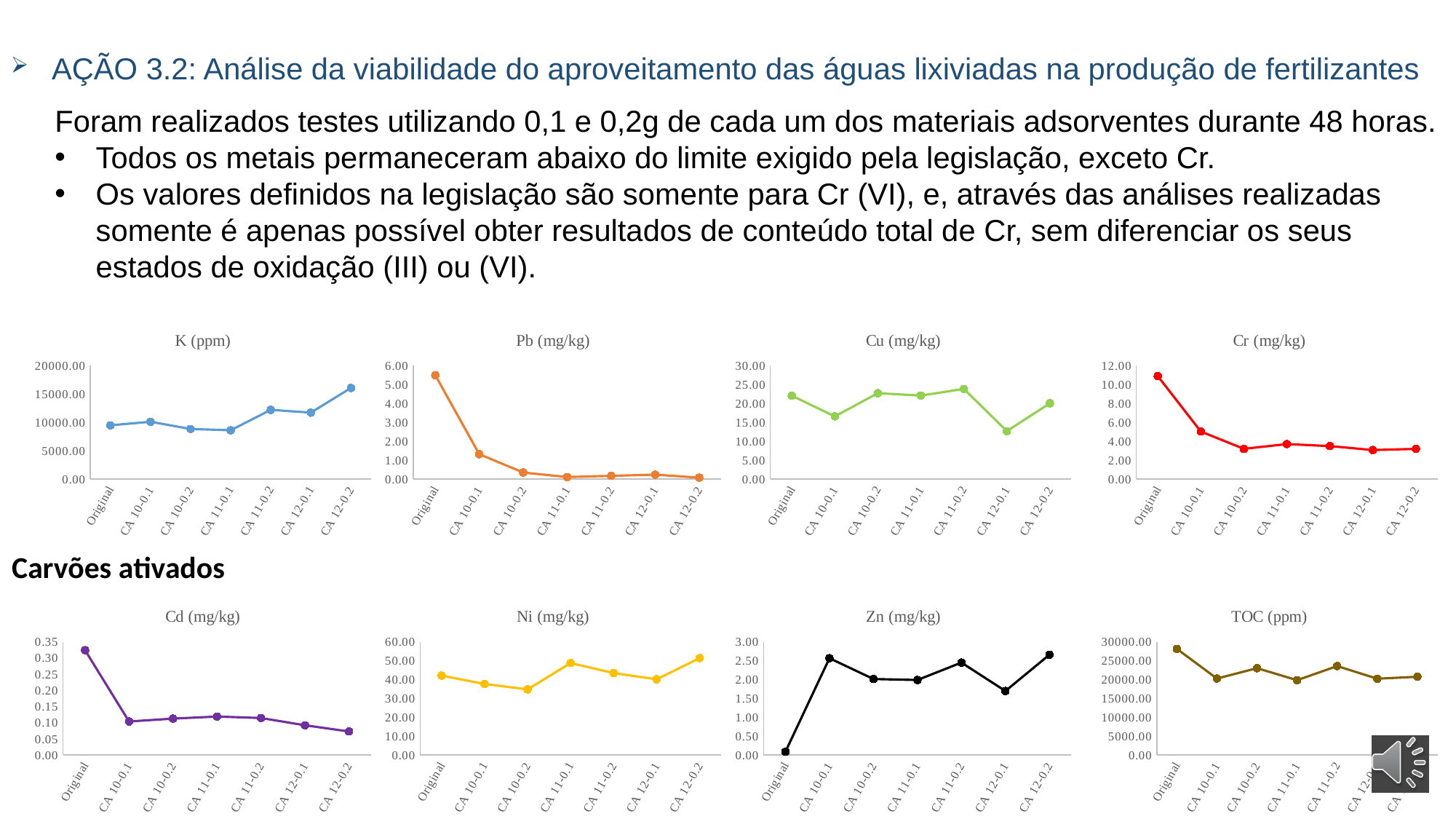
How many categories are plotted on the x axis of the K (ppm) chart? 7 In the Cr (mg/kg) chart, is the value for Original greater or less than 10.00? greater What kind of chart is the K (ppm) chart? line chart In the Pb (mg/kg) chart, which category has the highest value? Original In the Ni (mg/kg) chart, is the value for CA 10-0.2 greater or less than 40.00? less In the Cu (mg/kg) chart, which category has the lowest value? CA 12-0.1 How many charts are shown on the slide? 8 In the Cr (mg/kg) chart, which is larger, the value for Original or the value for CA 10-0.1? Original In the Cd (mg/kg) chart, which category has the highest value? Original In the Pb (mg/kg) chart, do the values generally rise or fall from Original to CA 12-0.2? fall In the Zn (mg/kg) chart, which category has the lowest value? Original In the K (ppm) chart, which category has the highest value? CA 12-0.2